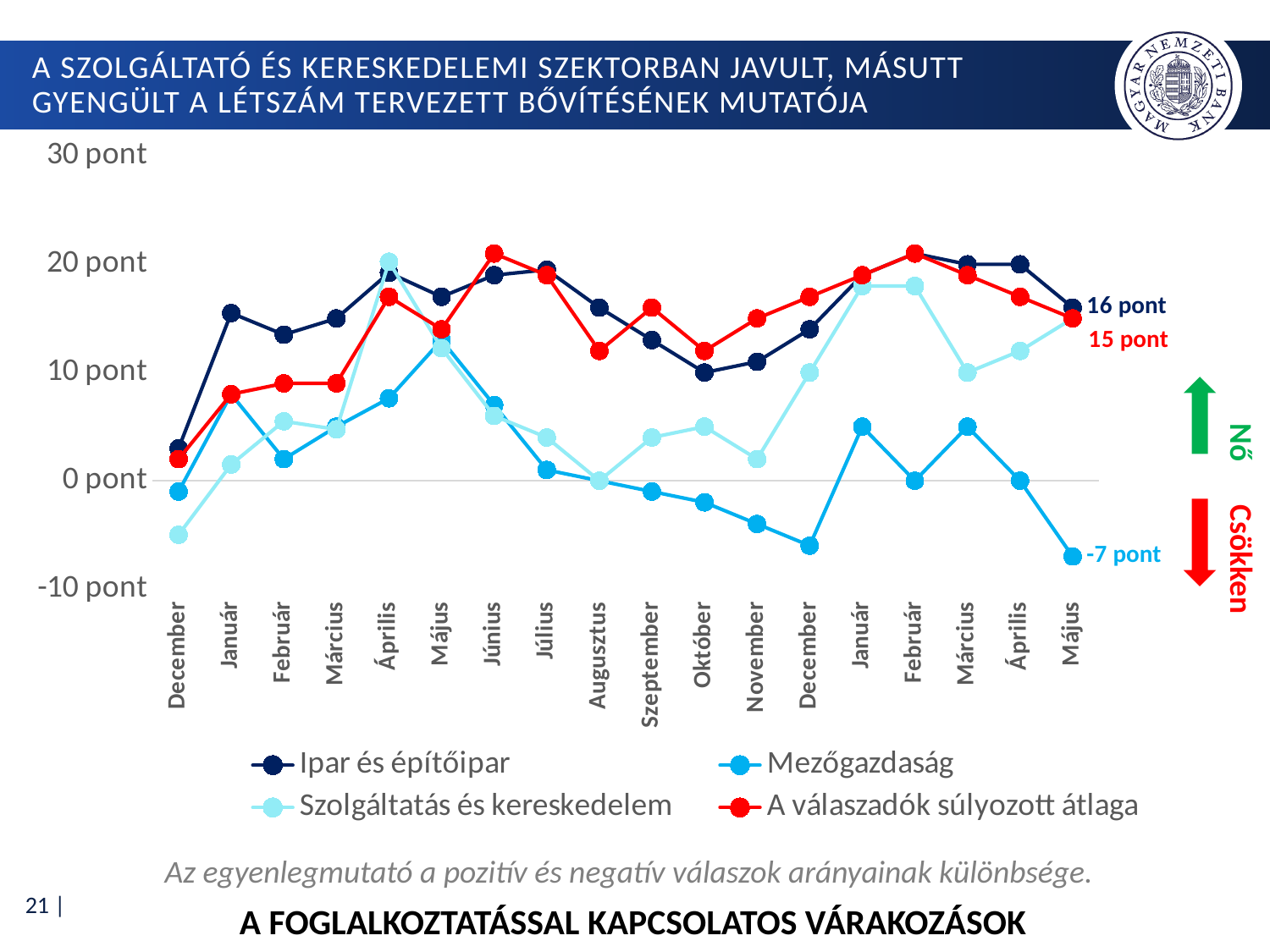
What is the value of Ipar és építőipar at the final Május point? 16 pont How many series does the legend list? 4 Is the value for Ipar és építőipar in the first Április greater or less than 10 pont? greater At the final Május point, which is larger: Ipar és építőipar or A válaszadók súlyozott átlaga? Ipar és építőipar What is the difference between Ipar és építőipar and Mezőgazdaság at the final Május point? 23 pont What kind of chart is shown on the slide? line chart Does the Mezőgazdaság line rise or fall from the second Március to the final Május? fall Which series has the lowest value at the final Május point? Mezőgazdaság How many months are shown along the x axis? 18 What is the value of A válaszadók súlyozott átlaga at the final Május point? 15 pont Is the value for Mezőgazdaság in the second December greater or less than 0 pont? less What is the value of Mezőgazdaság at the final Május point? -7 pont